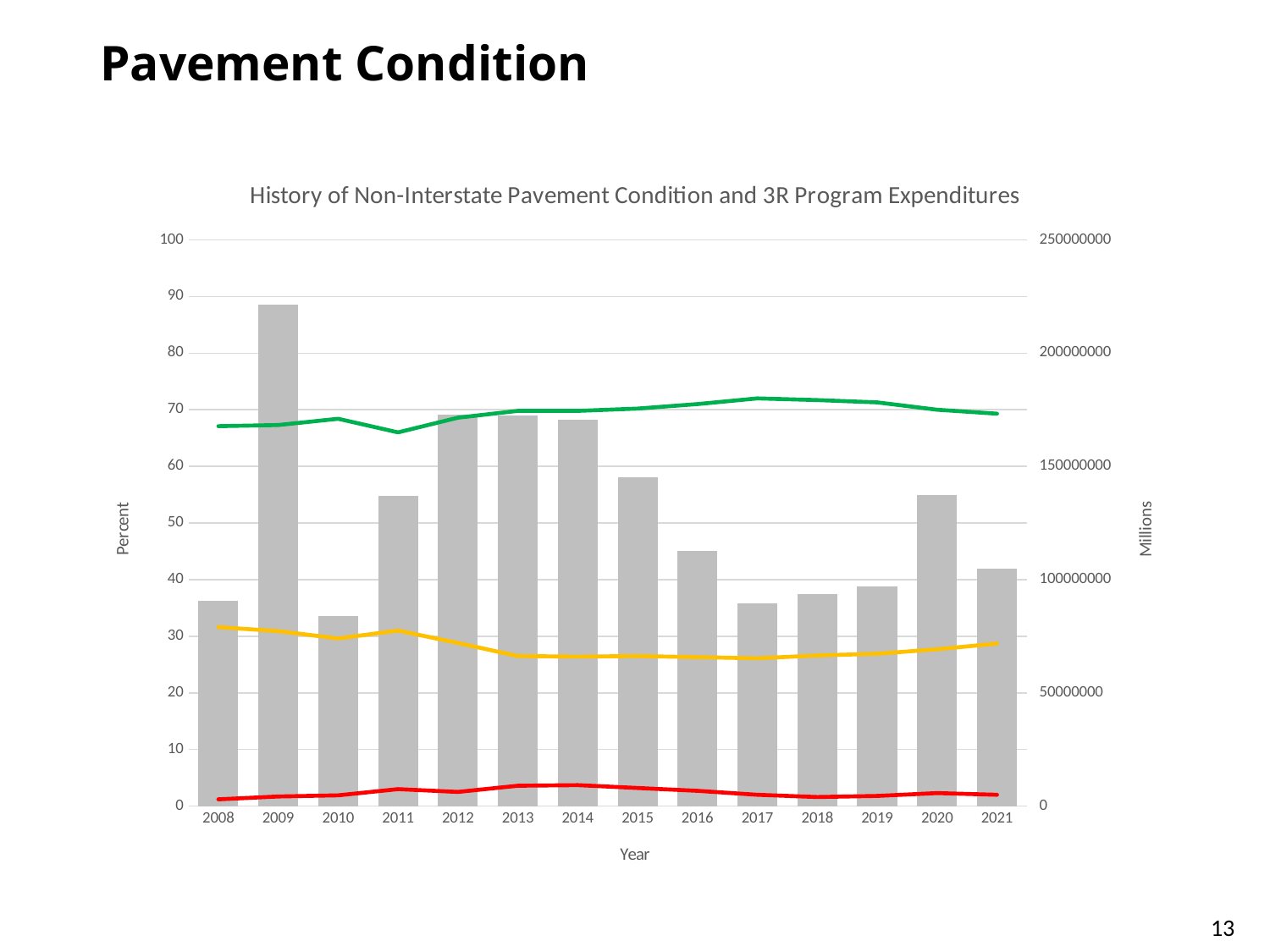
Is the gray bar for 2016 greater or less than 150000000 on the right-hand axis? less Which year has the tallest gray bar? 2009 Is the yellow line's value for 2013 greater or less than 30 percent? less What is the title of the chart? History of Non-Interstate Pavement Condition and 3R Program Expenditures Is the green line's value for 2017 greater or less than 70 percent? greater What is the label on the left-hand vertical axis? Percent Which gray bar is taller, 2015 or 2016? 2015 How many years are shown along the x axis of the chart? 14 Does the yellow line rise or fall from 2008 to 2013? fall Which year has the shortest gray bar? 2010 What kind of chart is shown on the slide? Combined bar and line chart